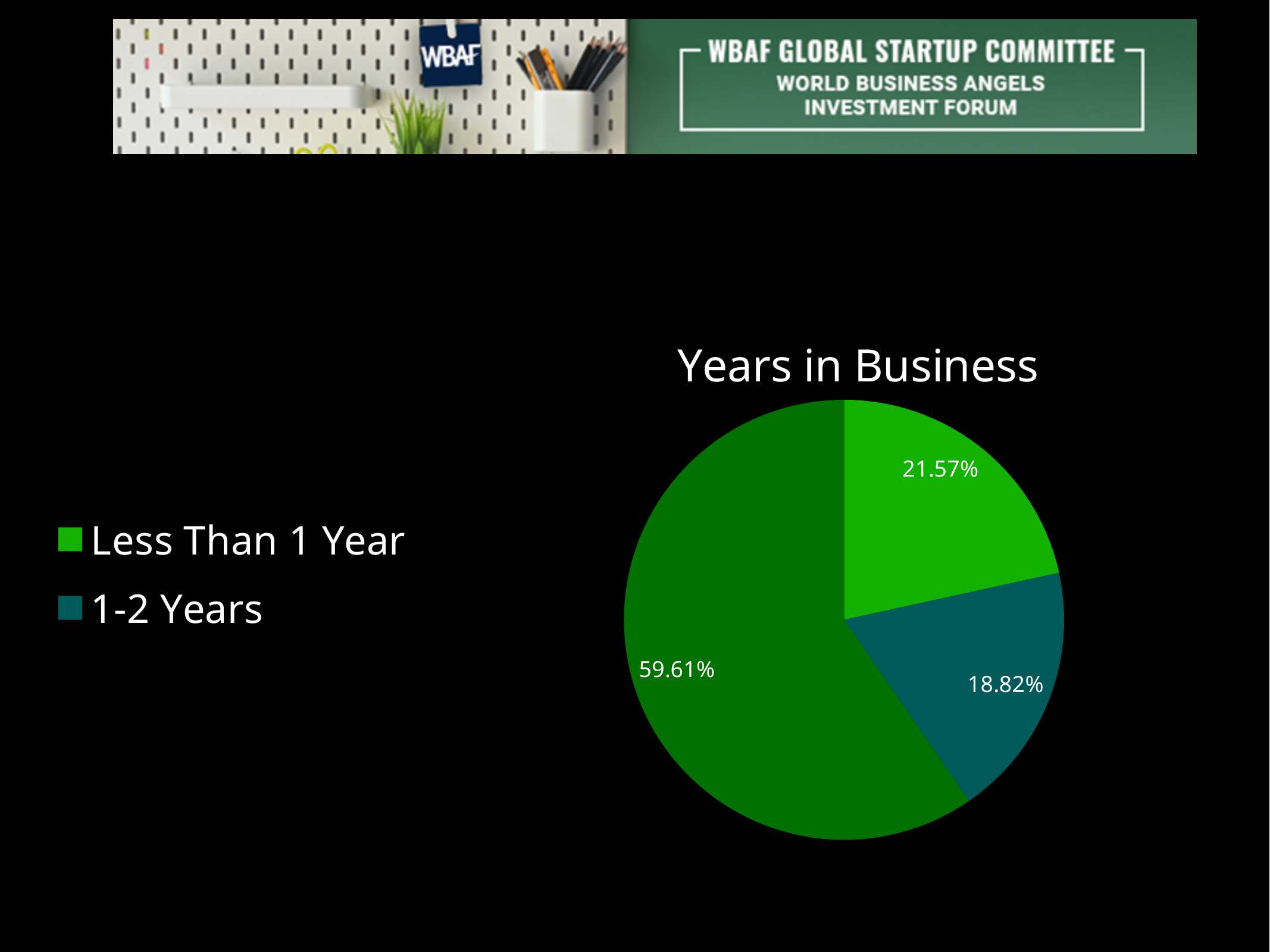
What is the title of the chart on the slide? Years in Business How many slices does the Years in Business pie chart have? 3 In the Years in Business chart, what is the difference in percentage points between Less Than 1 Year and 1-2 Years? 2.75 percentage points What is the largest percentage value labelled on the Years in Business pie chart? 59.61% What kind of chart is shown on the slide? Pie chart In the Years in Business chart, what colour is the Less Than 1 Year slice? Bright green Which category has the smallest slice in the Years in Business pie chart? 1-2 Years In the Years in Business chart, what do the Less Than 1 Year and 1-2 Years slices add up to? 40.39% How many entries does the legend of the Years in Business chart list? 2 In the Years in Business chart, which is larger: Less Than 1 Year or 1-2 Years? Less Than 1 Year In the Years in Business pie chart, what percentage is shown for Less Than 1 Year? 21.57% In the Years in Business pie chart, what percentage is shown for 1-2 Years? 18.82%